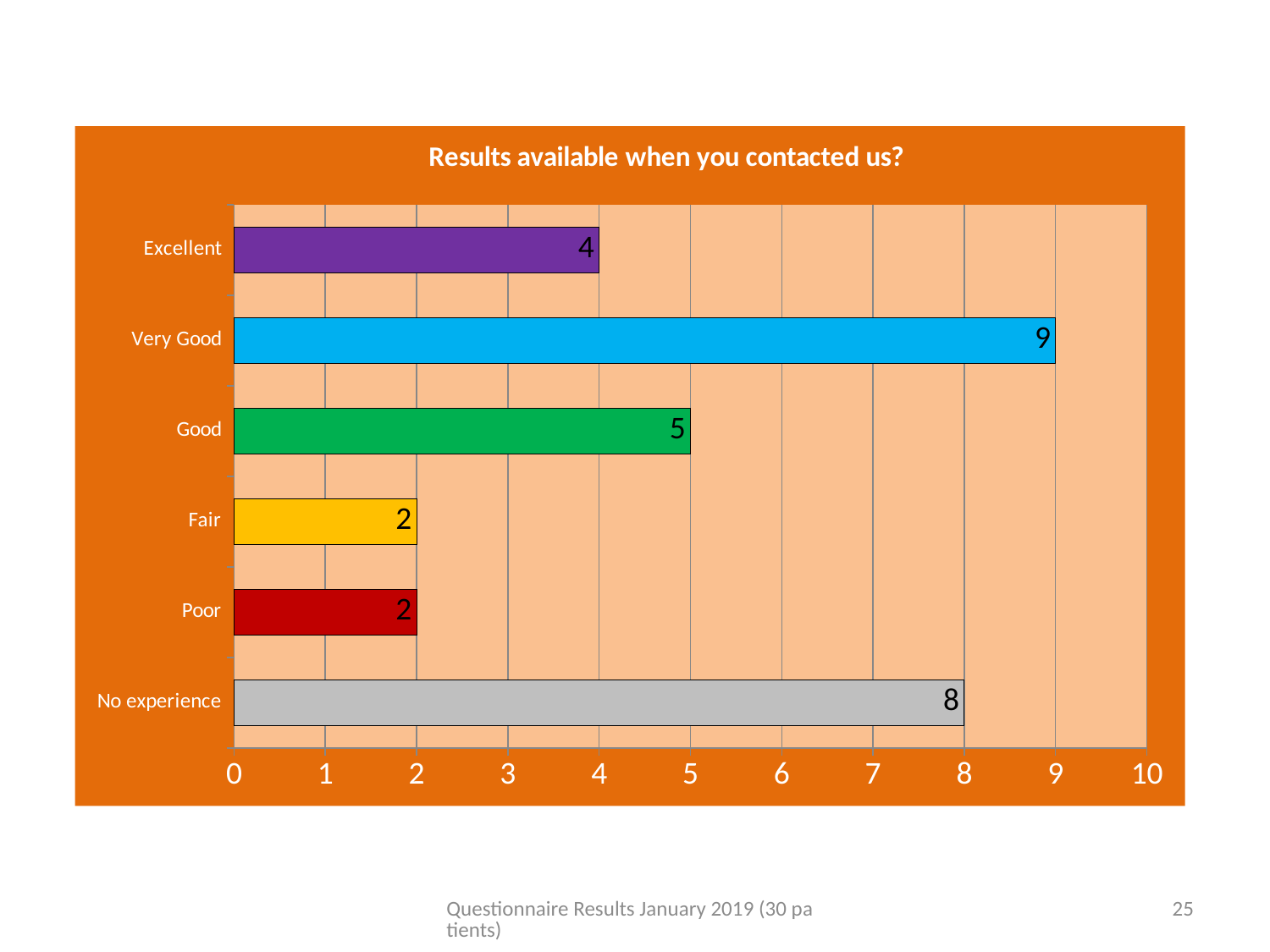
What is the difference between the values for Very Good and Excellent? 5 What is the difference between the values for No experience and Good? 3 Which is larger, the value for Good or the value for Excellent? Good Which category has the highest value? Very Good What is the title of the chart? Results available when you contacted us? What is the value for Excellent? 4 What is the value for Good? 5 Is the value for Very Good greater or less than 5? greater What is the value for Very Good? 9 What kind of chart is shown on the slide? bar chart How many categories are shown in the chart? 6 What is the value for No experience? 8